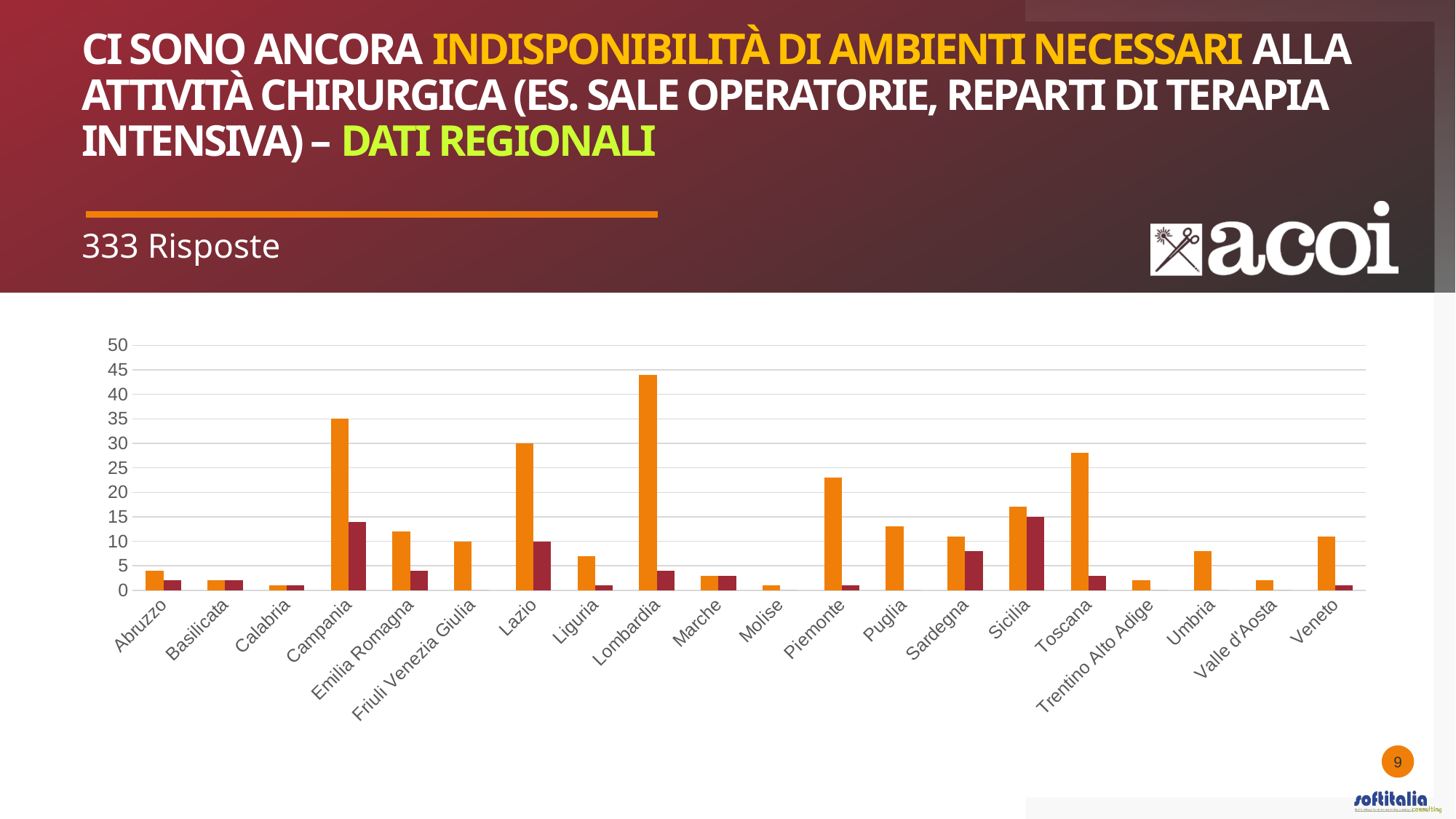
Is the orange bar for Liguria greater or less than 10? less What is the value of the orange bar for Lazio? 30 What kind of chart is shown on the slide? bar chart How many responses does the slide say the chart is based on? 333 Risposte What is the value of the dark red bar for Sicilia? 15 What is the value of the orange bar for Campania? 35 What is the value of the orange bar for Friuli Venezia Giulia? 10 How many regions are shown on the x axis of the chart? 20 Is the orange bar for Lombardia greater or less than 40? greater Which has the larger orange bar, Campania or Lazio? Campania Which region has the tallest orange bar? Lombardia Is the orange bar for Toscana greater or less than 25? greater